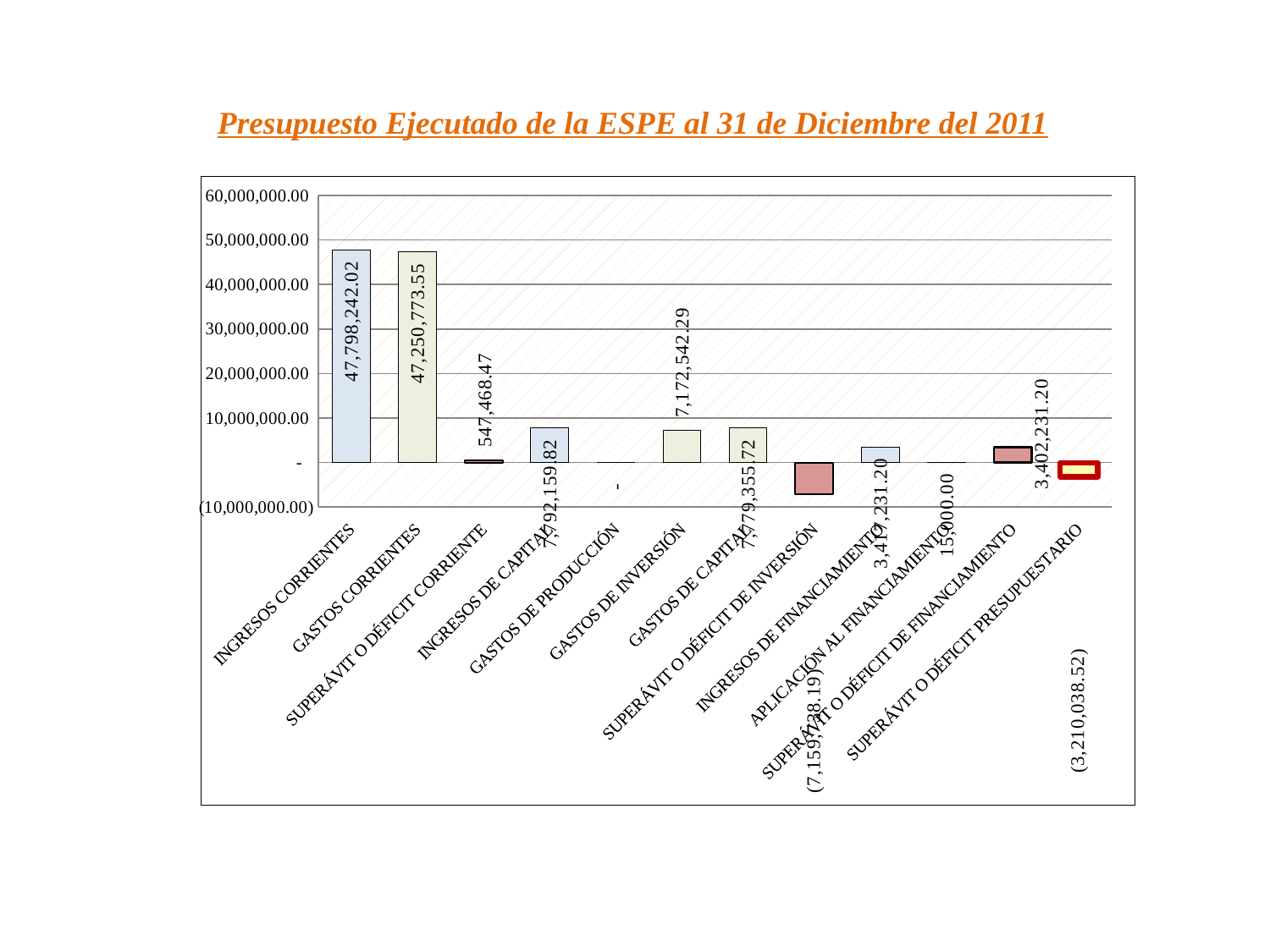
What is the value for GASTOS DE INVERSIÓN? 7,172,542.29 Which category has the highest value? INGRESOS CORRIENTES What is the value for SUPERÁVIT O DÉFICIT PRESUPUESTARIO? (3,210,038.52) Which category has the lowest value? SUPERÁVIT O DÉFICIT DE INVERSIÓN What is the value for SUPERÁVIT O DÉFICIT CORRIENTE? 547,468.47 What is the value for GASTOS CORRIENTES? 47,250,773.55 What is the value for APLICACIÓN AL FINANCIAMIENTO? 15,000.00 How many categories are shown on the x axis? 12 What is the value for INGRESOS CORRIENTES? 47,798,242.02 What is the difference between INGRESOS CORRIENTES and GASTOS CORRIENTES? 547,468.47 Is the value for GASTOS DE INVERSIÓN greater or less than 10,000,000.00? less What kind of chart is shown on the slide? bar chart